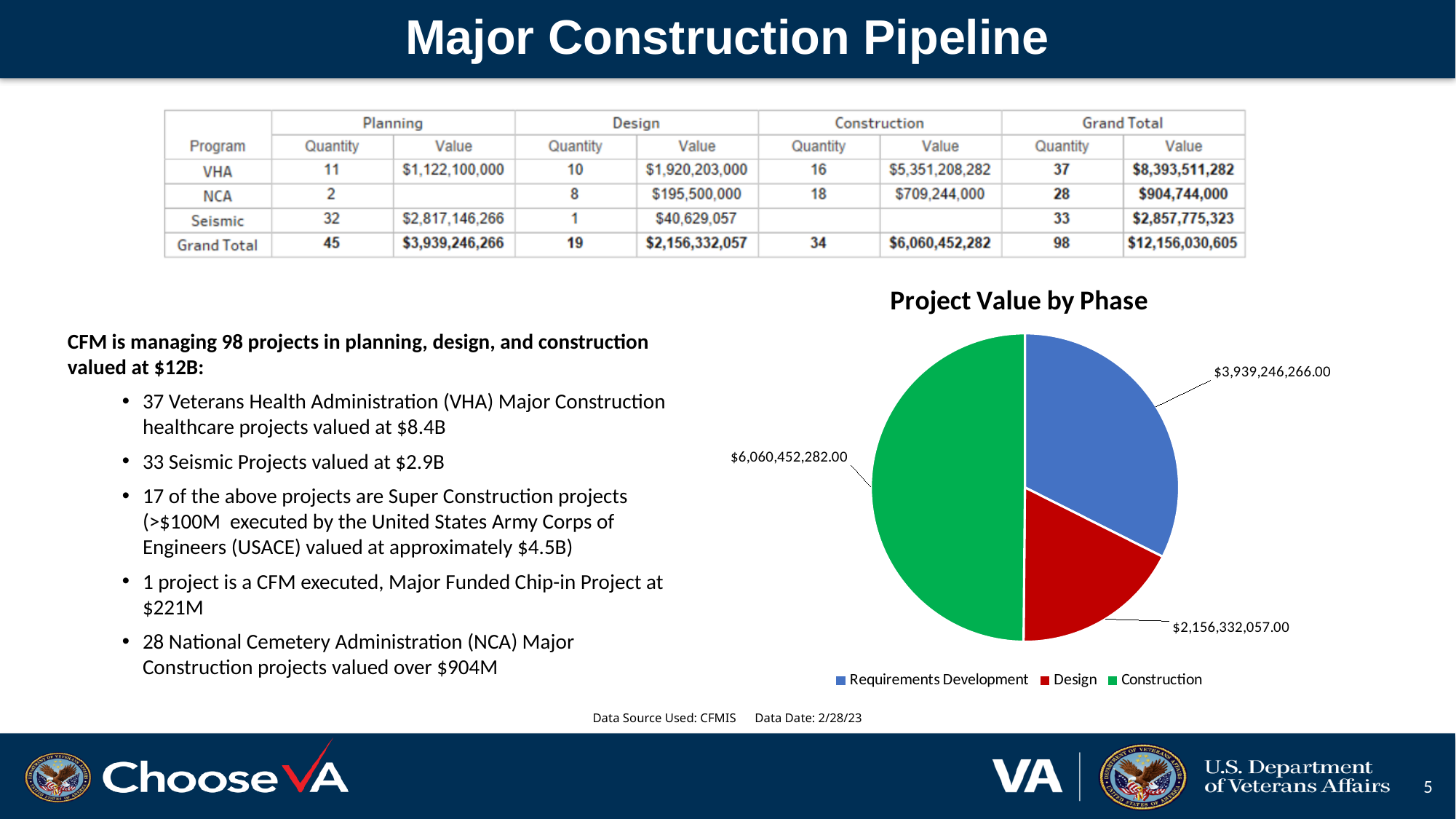
What is the title of the chart on the slide? Project Value by Phase Which phase has the largest slice in the Project Value by Phase chart? Construction In the Project Value by Phase chart, how much larger is the Construction value than the Requirements Development value? $2,121,206,016.00 In the Project Value by Phase chart, what is the value of the Construction slice? $6,060,452,282.00 In the Project Value by Phase chart, what is the value of the Design slice? $2,156,332,057.00 In the Project Value by Phase chart, what is the value of the Requirements Development slice? $3,939,246,266.00 How many slices does the Project Value by Phase pie chart have? 3 Which phase has the smallest slice in the Project Value by Phase chart? Design What colour is the Construction slice in the Project Value by Phase chart? Green What is the total of all three slices in the Project Value by Phase chart? $12,156,030,605.00 What type of chart is shown under the title "Project Value by Phase"? Pie chart In the Project Value by Phase chart, which is larger: Requirements Development or Design? Requirements Development